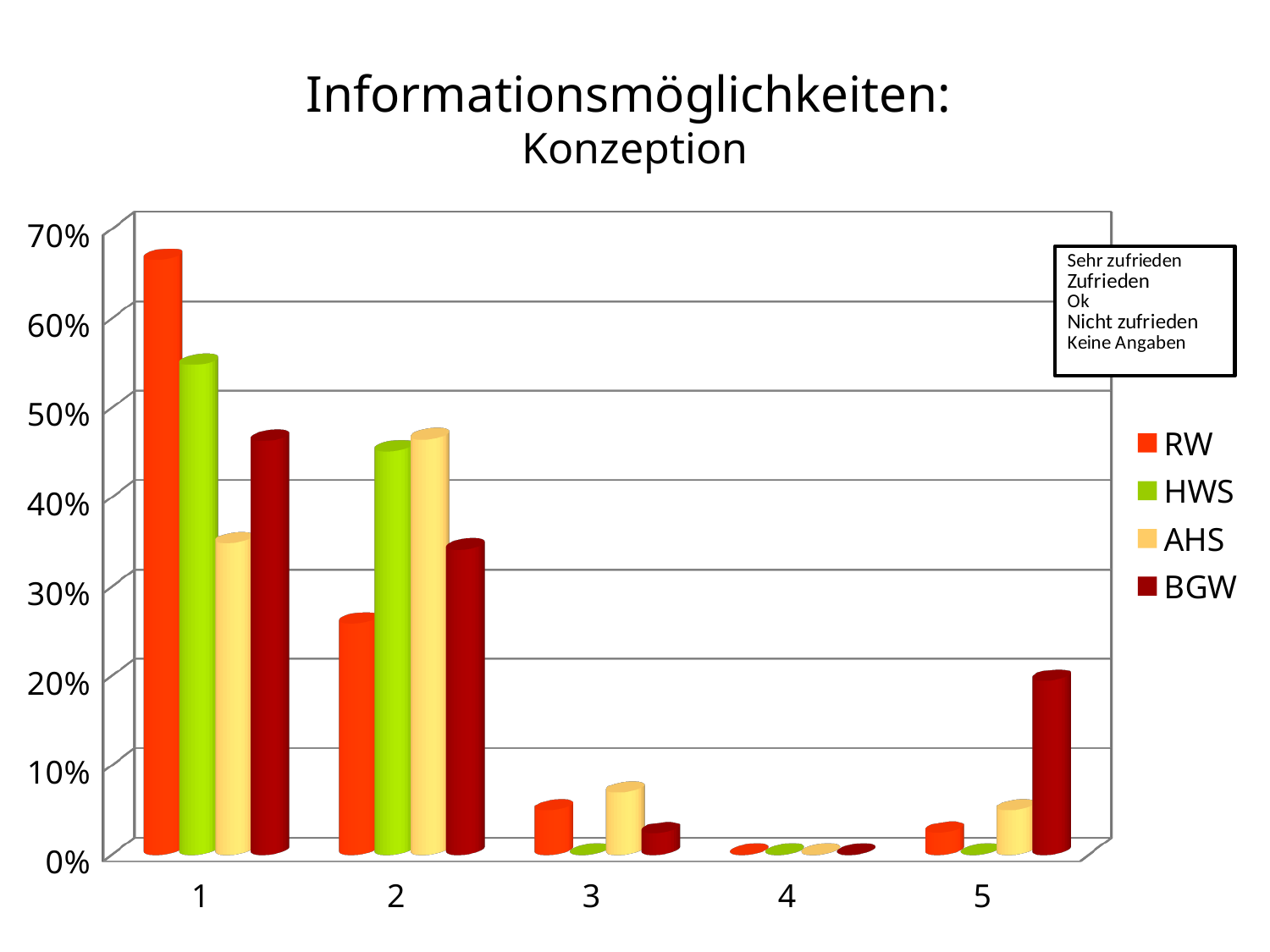
In category 5, which series has the highest bar? BGW Is the value for BGW in category 5 greater or less than 10%? greater Is the value for AHS in category 1 greater or less than 40%? less For which category is the RW bar highest? 1 Is the value for RW in category 1 greater or less than 60%? greater What is the title of the chart? Informationsmöglichkeiten: Konzeption How many series does the legend list? 4 What kind of chart is shown on the slide? bar chart Which series does the legend list first? RW How many categories are shown on the x axis? 5 In category 2, which is larger, the value for RW or the value for HWS? HWS